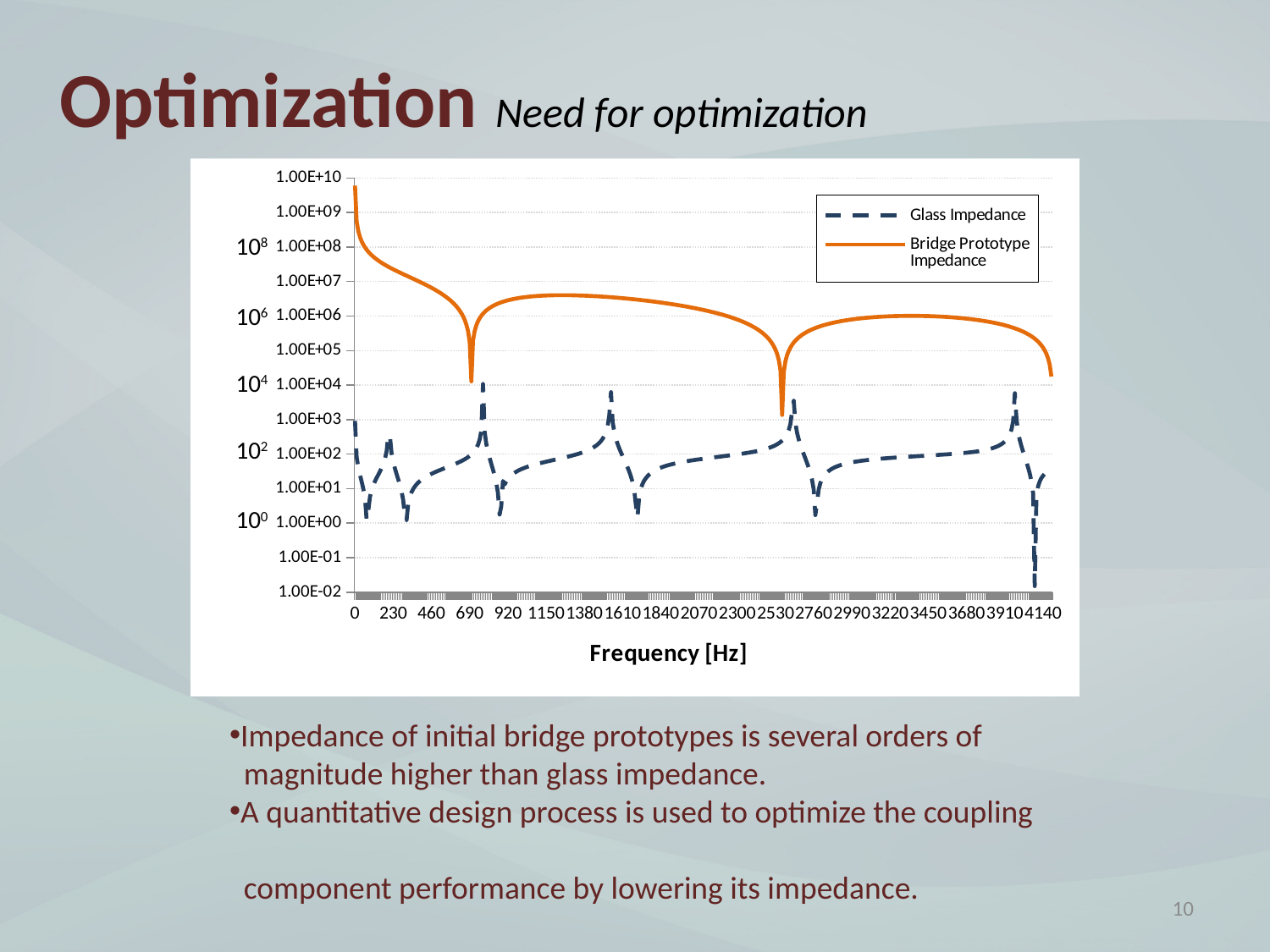
Is the Bridge Prototype Impedance at 3450 Hz greater or less than 1.00E+05? greater What is the title of the x axis? Frequency [Hz] What are the two series named in the legend? Glass Impedance and Bridge Prototype Impedance Is the Bridge Prototype Impedance at 1150 Hz greater or less than 1.00E+05? greater At 2300 Hz, which series has the higher impedance, Glass Impedance or Bridge Prototype Impedance? Bridge Prototype Impedance Is the Glass Impedance at 3450 Hz greater or less than 1.00E+03? less At 1150 Hz, which series has the lower impedance? Glass Impedance Which series is drawn with a dashed line? Glass Impedance Does the Bridge Prototype Impedance rise or fall between 0 Hz and 690 Hz? fall How many series does the legend list? 2 What kind of chart is shown on the slide? Line chart